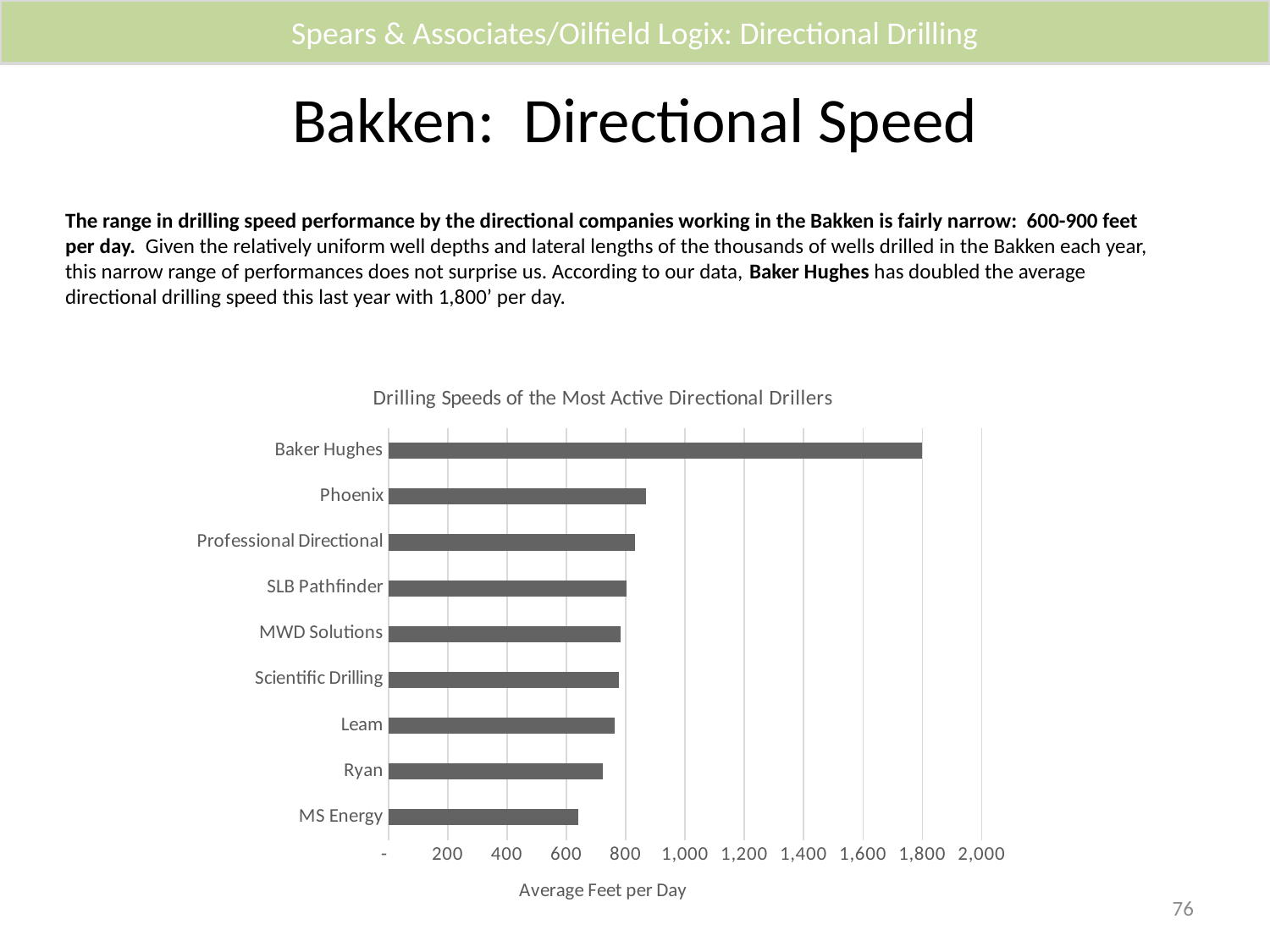
What is the label on the horizontal axis of the chart? Average Feet per Day Is the value for Baker Hughes greater or less than 1,600? greater Which has a higher average feet per day, Phoenix or MS Energy? Phoenix What kind of chart is shown on the slide? bar chart Which company has the lowest average feet per day in the chart? MS Energy Is the value for MS Energy greater or less than 800? less Which company has the highest average feet per day in the chart? Baker Hughes How many directional drilling companies are plotted in the chart? 9 What is the average feet per day for Baker Hughes? 1,800 What is the title of the chart? Drilling Speeds of the Most Active Directional Drillers Is the value for Phoenix greater or less than 800? greater